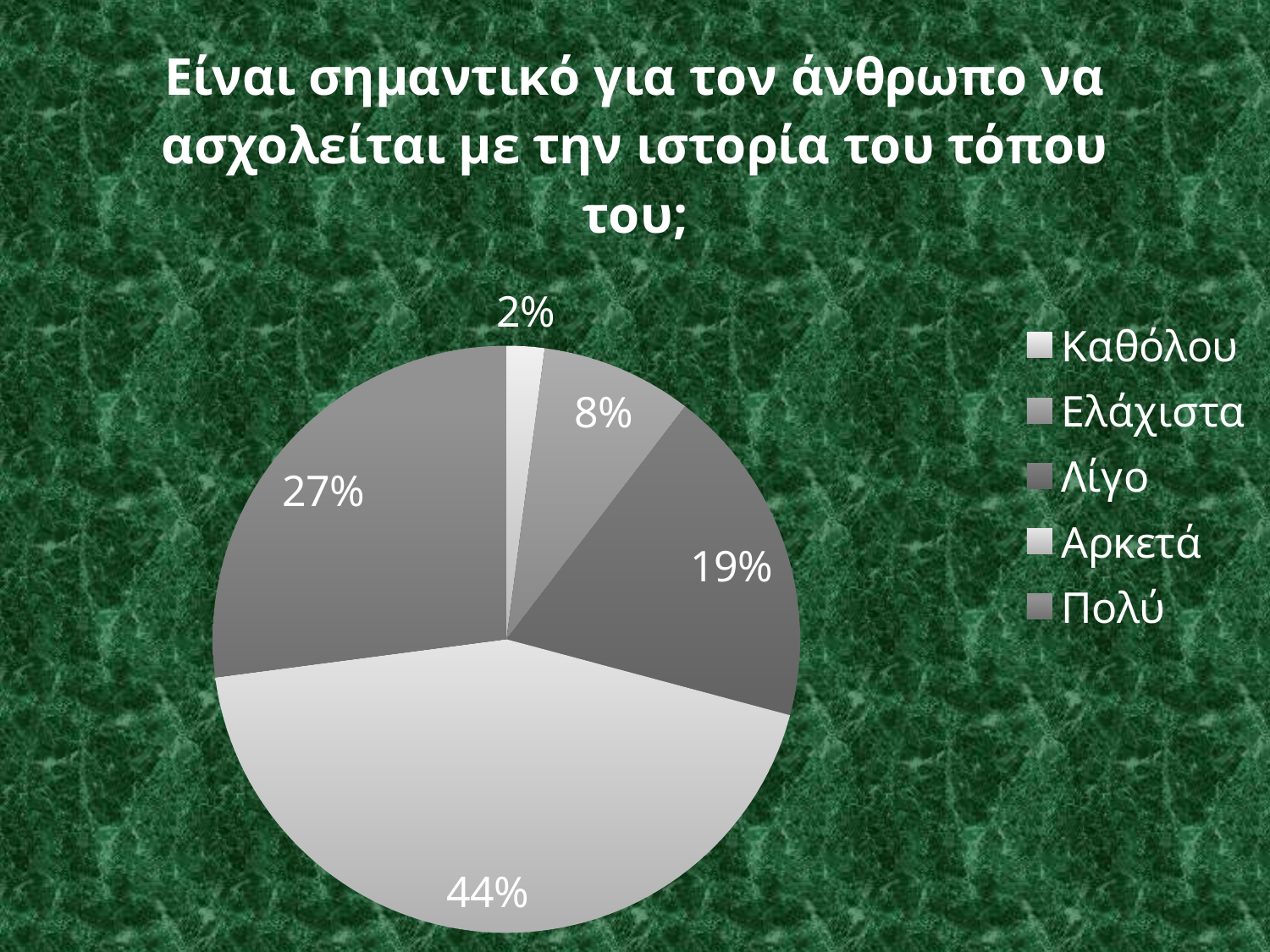
What is the difference in percentage points between the Αρκετά slice and the Πολύ slice? 17 How many categories does the legend list? 5 What kind of chart is shown on the slide? pie chart Which slice is larger, Λίγο or Ελάχιστα? Λίγο Which category has the largest slice of the pie? Αρκετά Which category has the smallest slice of the pie? Καθόλου What is the title of the chart? Είναι σημαντικό για τον άνθρωπο να ασχολείται με την ιστορία του τόπου του; What percentage of the pie is the Αρκετά slice? 44% What percentage of the pie is the Καθόλου slice? 2% What percentage of the pie is the Ελάχιστα slice? 8% What percentage of the pie is the Λίγο slice? 19% What percentage of the pie is the Πολύ slice? 27%